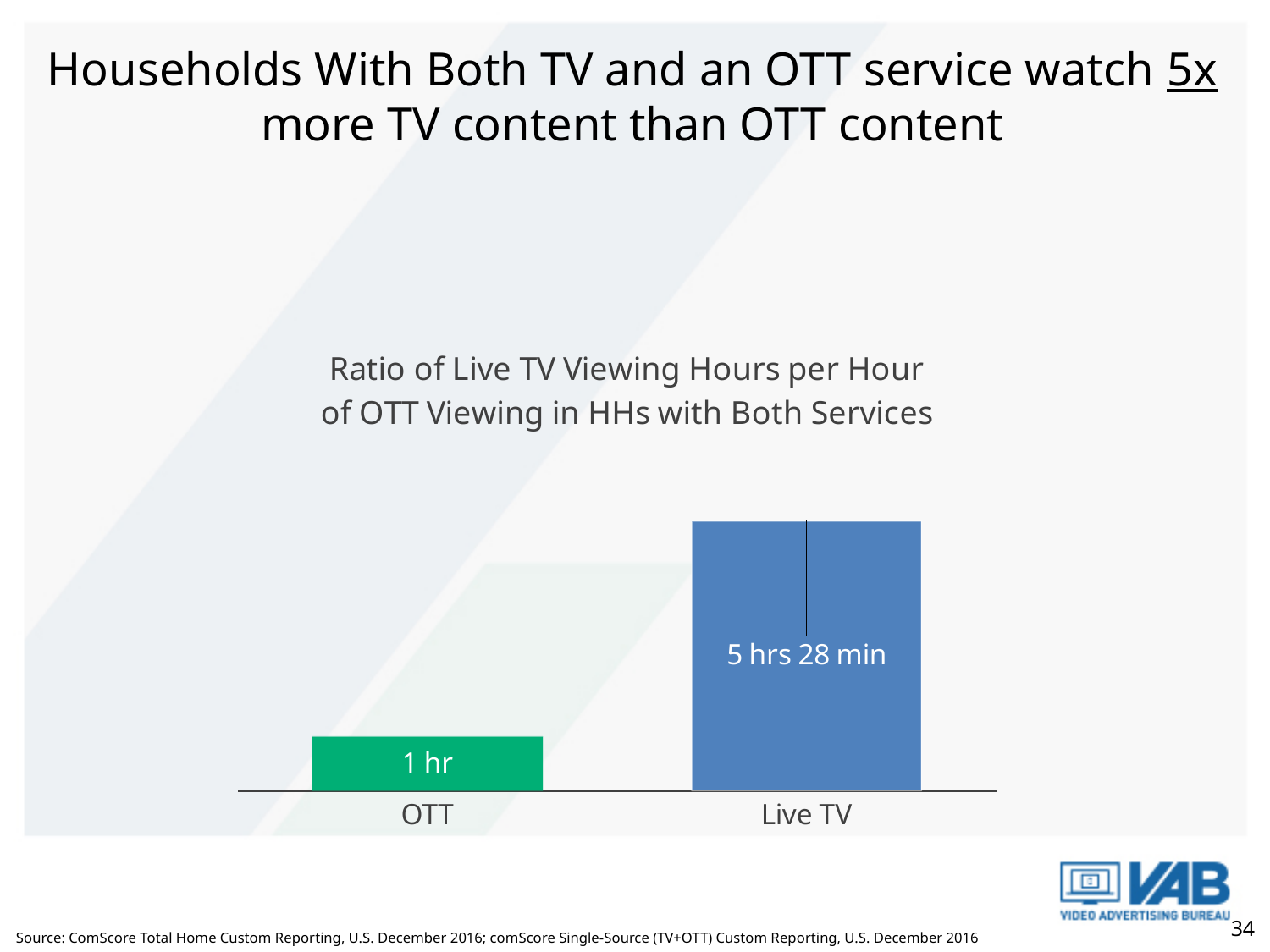
What kind of chart is shown on the slide? Bar chart Which is larger, the value for OTT or the value for Live TV? Live TV What is the difference between the Live TV value and the OTT value? 4 hrs 28 min What is the value shown for OTT? 1 hr What is the title of the chart? Ratio of Live TV Viewing Hours per Hour of OTT Viewing in HHs with Both Services What is the value shown for Live TV? 5 hrs 28 min Which category has the highest value? Live TV How many categories are shown in the chart? 2 What colour is the bar for OTT? Green Which category has the lowest value? OTT